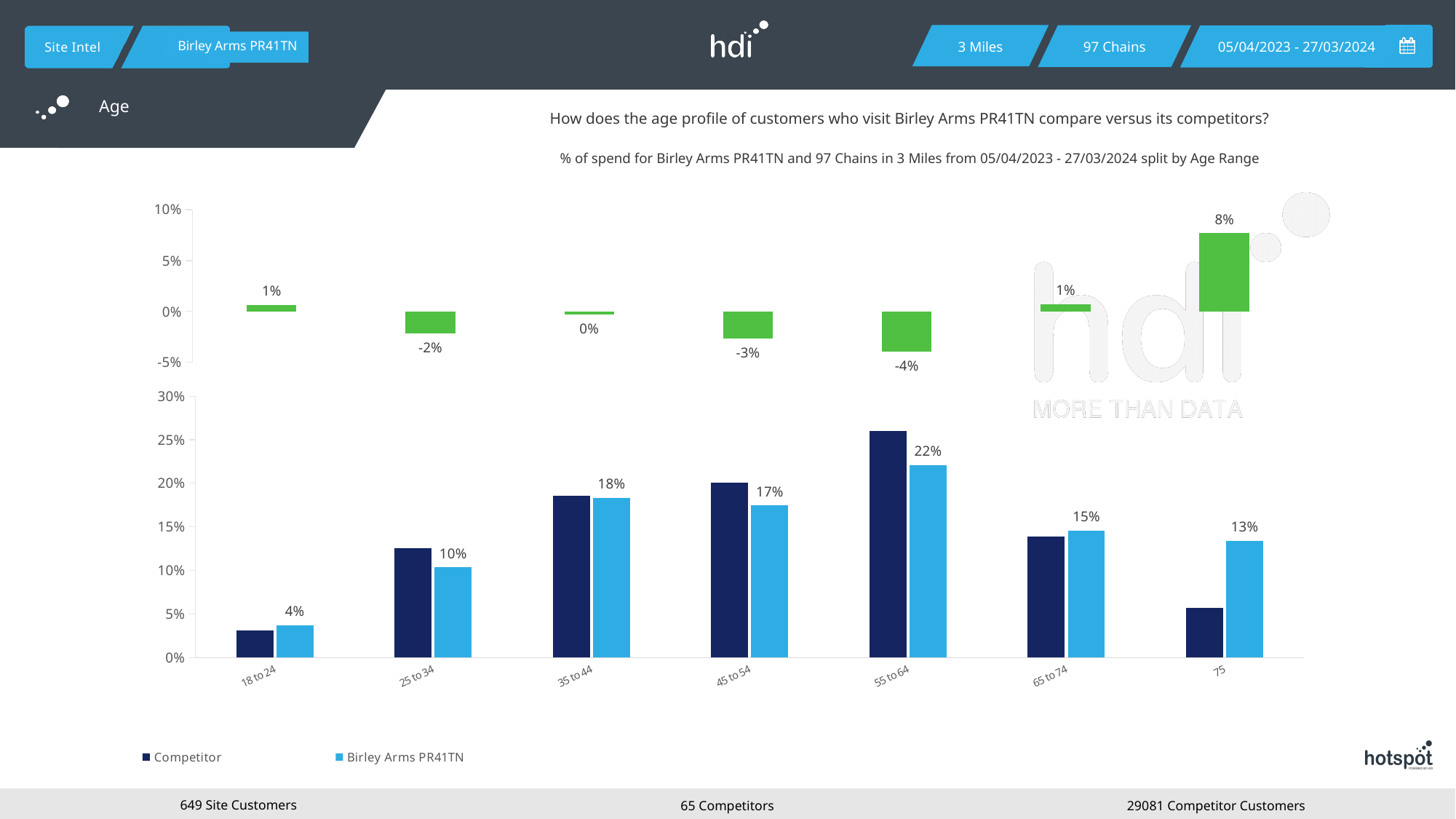
How many series does the legend of the bottom chart list? 2 In the bottom chart, which age range has the lowest Birley Arms PR41TN value? 18 to 24 In the bottom chart, is the Competitor value for 55 to 64 greater or less than 25%? greater In the bottom chart, which is larger for the 75 age range, Competitor or Birley Arms PR41TN? Birley Arms PR41TN How many age range categories are shown on the bottom chart? 7 In the bottom chart, is the Competitor value for 75 greater or less than 10%? less In the top chart, which age range has the highest value? 75 In the bottom chart, what is the value for Birley Arms PR41TN in the 55 to 64 age range? 22% In the bottom chart, what is the difference between the Birley Arms PR41TN values for 35 to 44 and 25 to 34? 8% In the bottom chart, what is the value for Birley Arms PR41TN in the 18 to 24 age range? 4% In the top chart, what is the value for the 55 to 64 age range? -4% In the bottom chart, which age range has the highest Birley Arms PR41TN value? 55 to 64